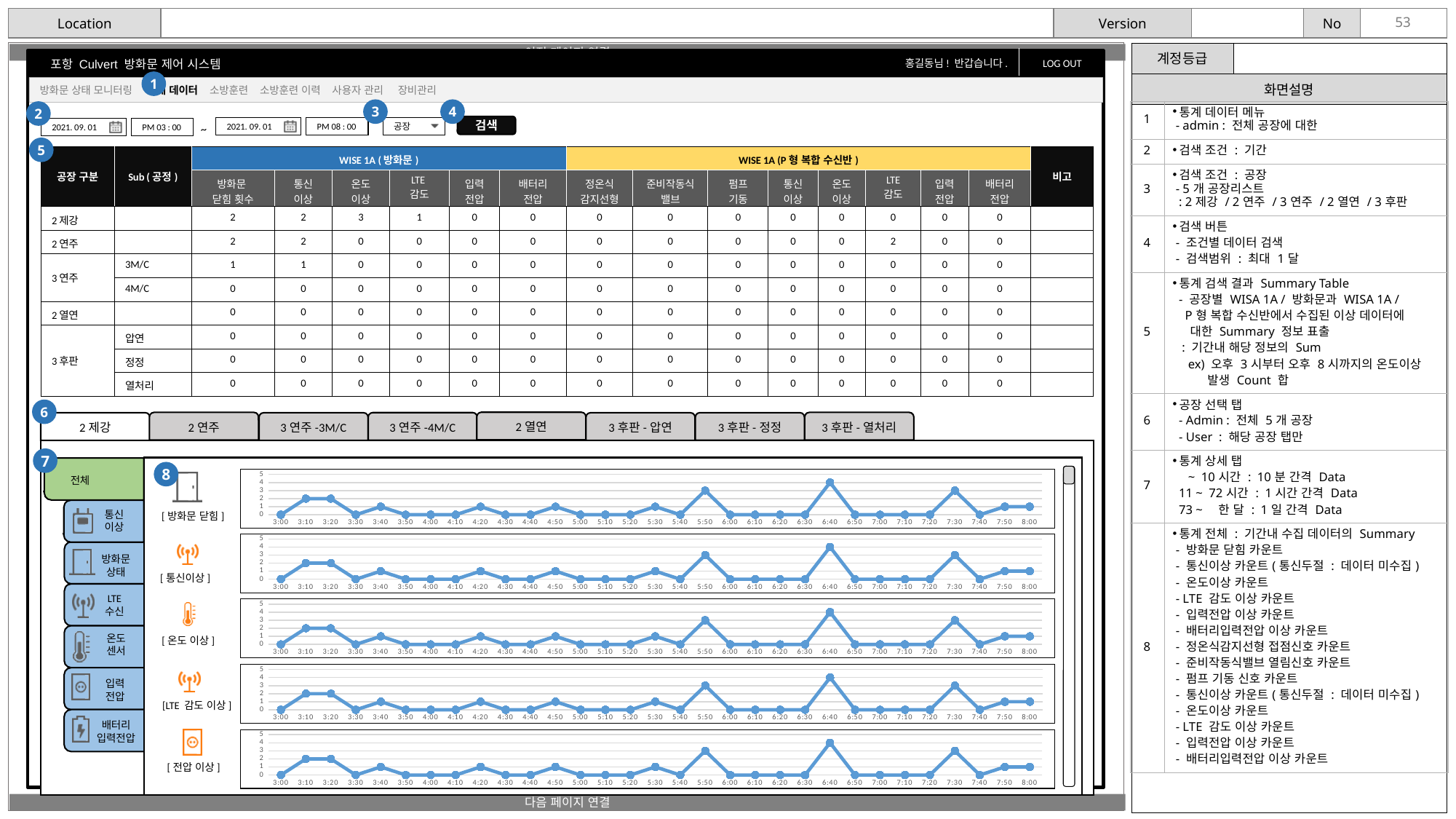
In the [온도 이상] chart, is the value at 5:50 greater or less than 2? greater In the [전압 이상] chart, which is larger, the value at 6:40 or the value at 7:30? 6:40 In the [방화문 닫힘] chart, at which time does the line reach its highest point? 6:40 In the [LTE 감도 이상] chart, which is larger, the value at 5:50 or the value at 6:00? 5:50 How many line charts are shown in the lower part of the slide? 5 In the [방화문 닫힘] chart, is the value at 6:40 greater or less than 3? greater What is the last time label on the x axis of the [전압 이상] chart? 8:00 What is the first time label on the x axis of the [방화문 닫힘] chart? 3:00 In the [방화문 닫힘] chart, is the value at 3:00 greater or less than 1? less What is the highest value shown on the y axis of the [통신이상] chart? 5 What kind of chart is the top chart labelled [방화문 닫힘]? line chart In the [통신이상] chart, at which time does the line reach its highest point? 6:40